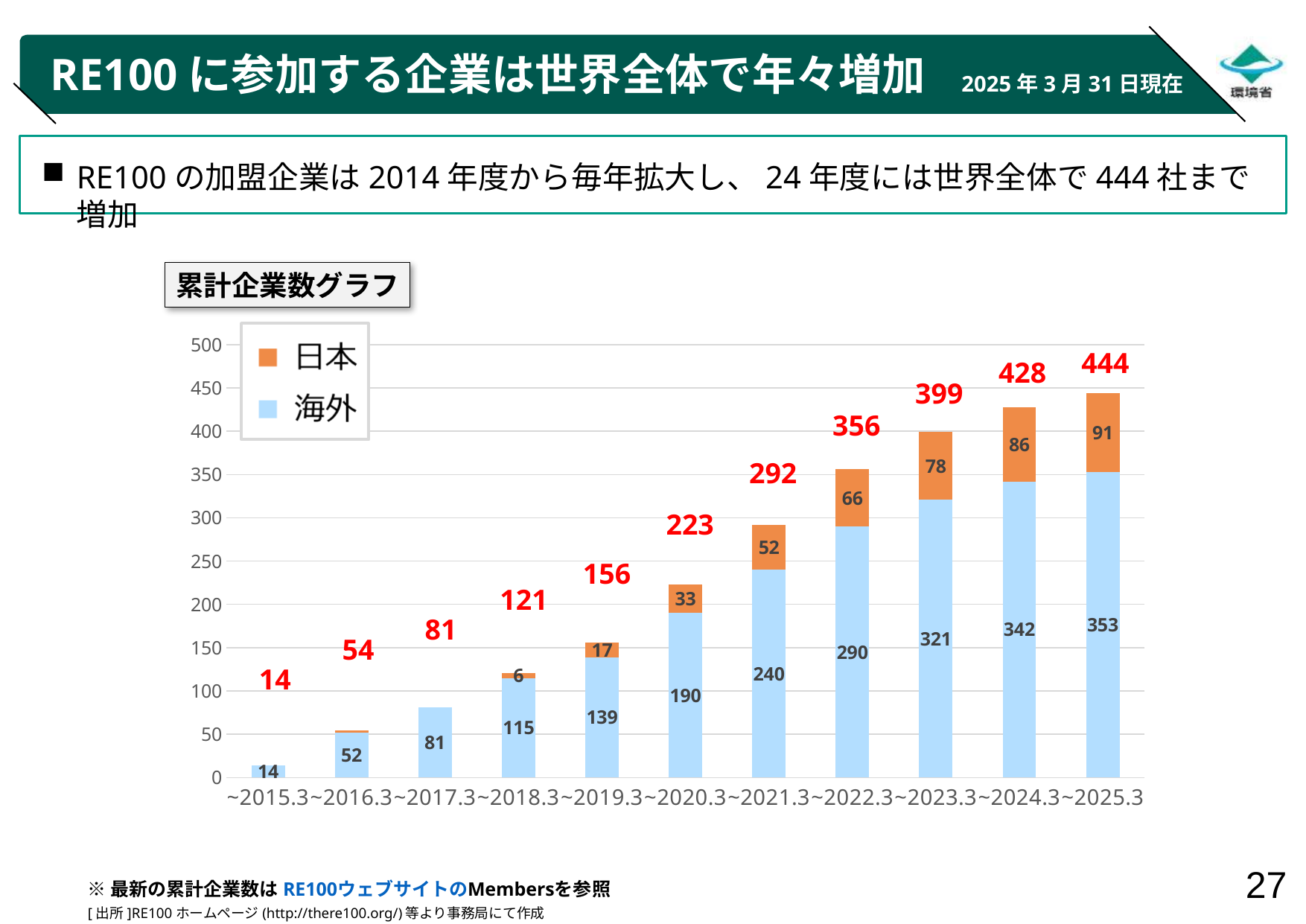
How many series does the legend list? 2 What kind of chart is shown? stacked bar chart Which period has the lowest total number of companies? ~2015.3 Is the total for ~2023.3 greater or less than 400? less What is the 海外 value for ~2021.3? 240 How many periods are shown on the x axis? 11 Do the total values rise or fall from ~2015.3 to ~2025.3? rise What is the total shown above the bar for ~2020.3? 223 Which period has the highest total number of companies? ~2025.3 What is the difference between the 海外 values for ~2025.3 and ~2024.3? 11 Which is larger, the 日本 value for ~2022.3 or the 日本 value for ~2019.3? ~2022.3 What is the 日本 value for ~2025.3? 91